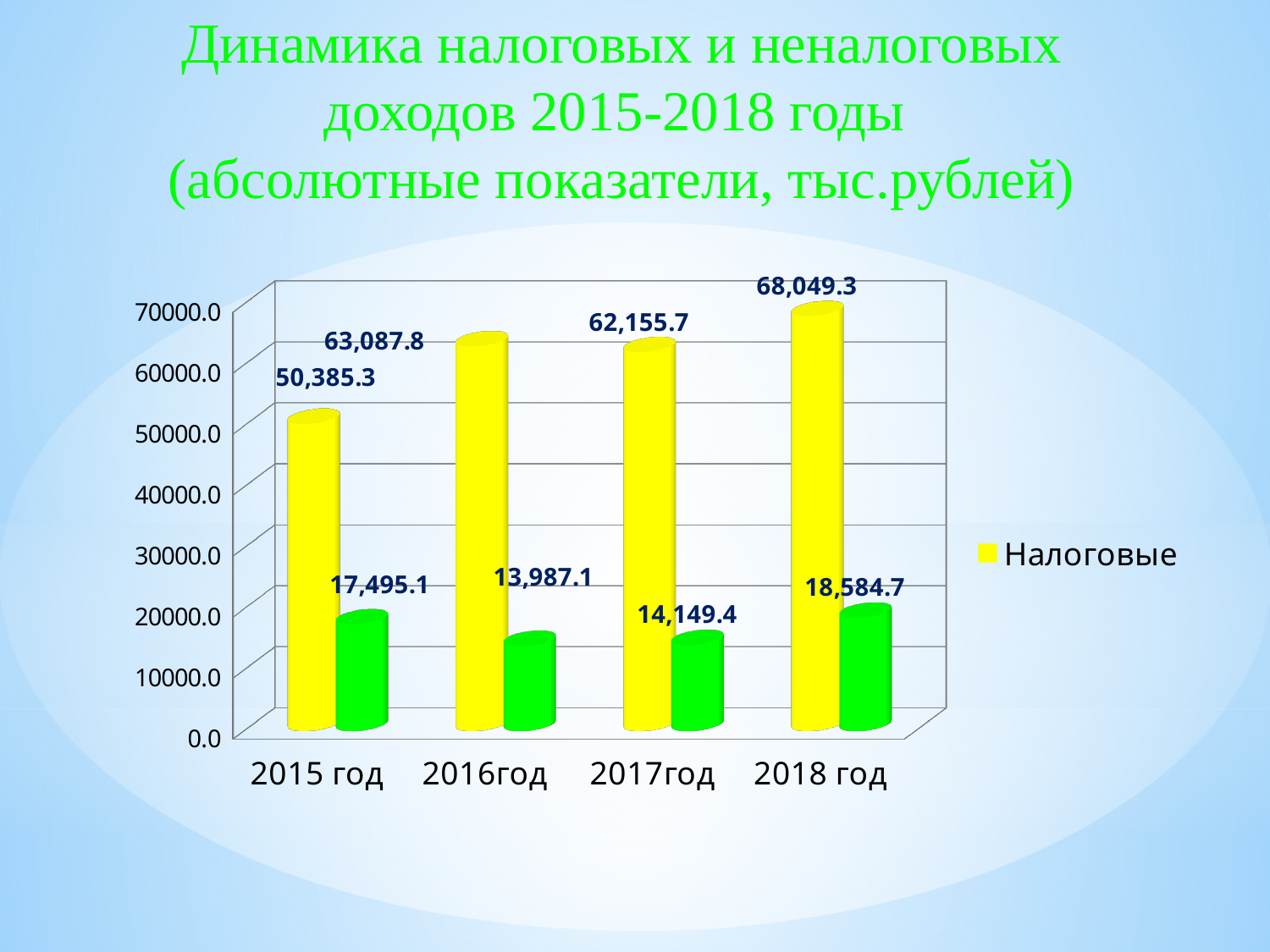
What is the value of the Налоговые series for 2018 год? 68,049.3 What is the value of the Налоговые series for 2015 год? 50,385.3 What is the difference between the Налоговые values for 2018 год and 2015 год? 17,664.0 In which year is the green bar lowest? 2016год How many years are shown on the x axis of the chart? 4 What is the value of the green bar for 2017год? 14,149.4 What is the difference between the green bar values for 2018 год and 2017год? 4,435.3 Which year has the larger Налоговые value, 2016год or 2017год? 2016год In which year is the Налоговые value highest? 2018 год What kind of chart is shown on the slide? Bar chart In which year is the Налоговые value lowest? 2015 год What is the value of the green bar for 2016год? 13,987.1